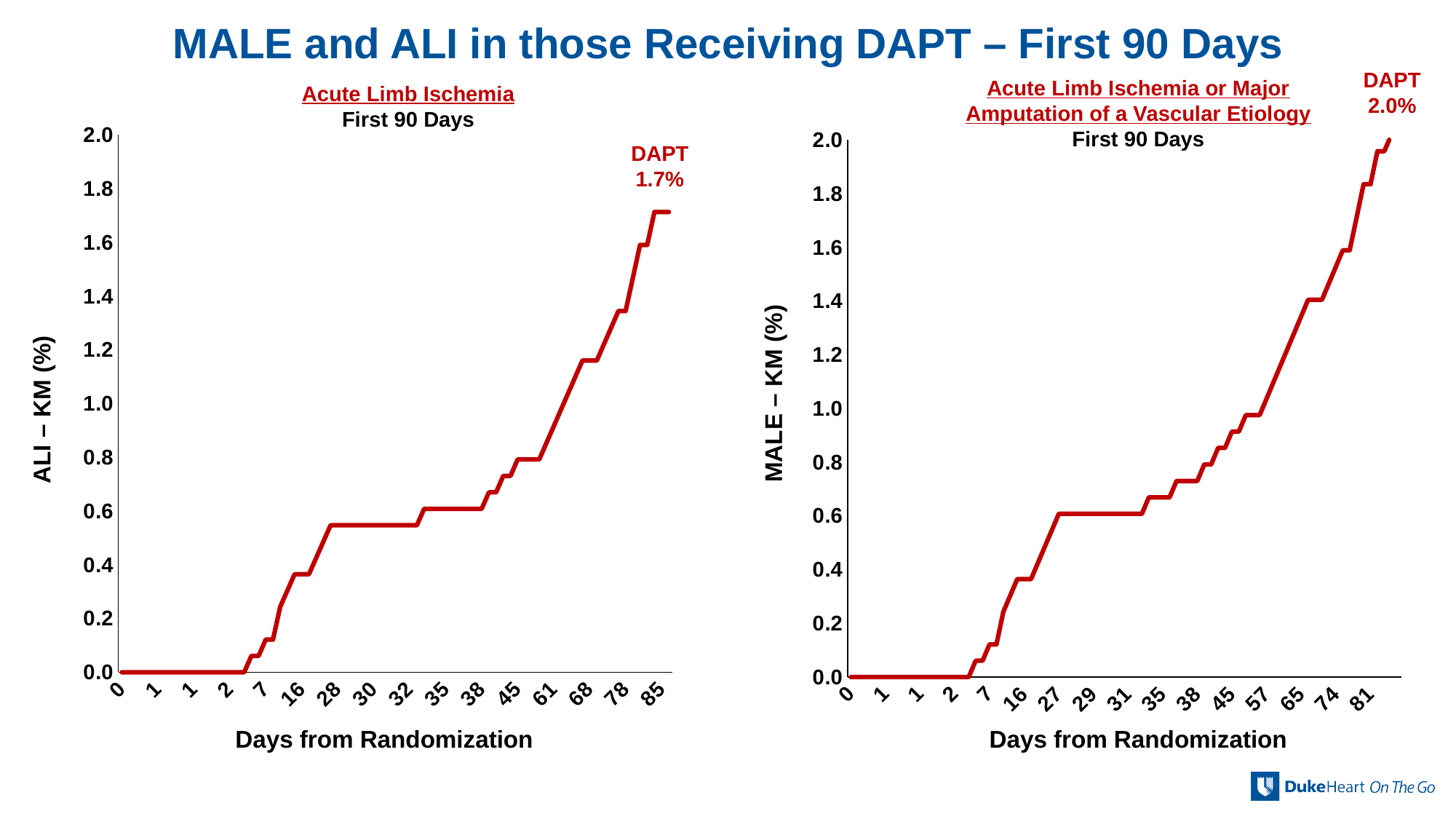
What kind of chart is the left chart (Acute Limb Ischemia)? Line chart On the right chart, does the curve rise or fall as days from randomization increase? Rise Which chart ends with the higher DAPT value, the left ALI chart or the right MALE chart? The right MALE chart On the left chart, is the value at day 61 greater or less than 0.6? greater On the left chart (Acute Limb Ischemia), what is the DAPT value labelled at the end of the curve? 1.7% What is the difference between the final DAPT value on the right chart (2.0%) and the final DAPT value on the left chart (1.7%)? 0.3% On the right chart (Acute Limb Ischemia or Major Amputation of a Vascular Etiology), what is the DAPT value labelled at the end of the curve? 2.0% What is the x-axis title on the left chart? Days from Randomization How many lines (series) are plotted on the right chart? 1 On the right chart, is the value at day 65 greater or less than 1.2? greater On the left chart, is the value at day 7 greater or less than 0.4? less What is the y-axis title on the right chart? MALE – KM (%)